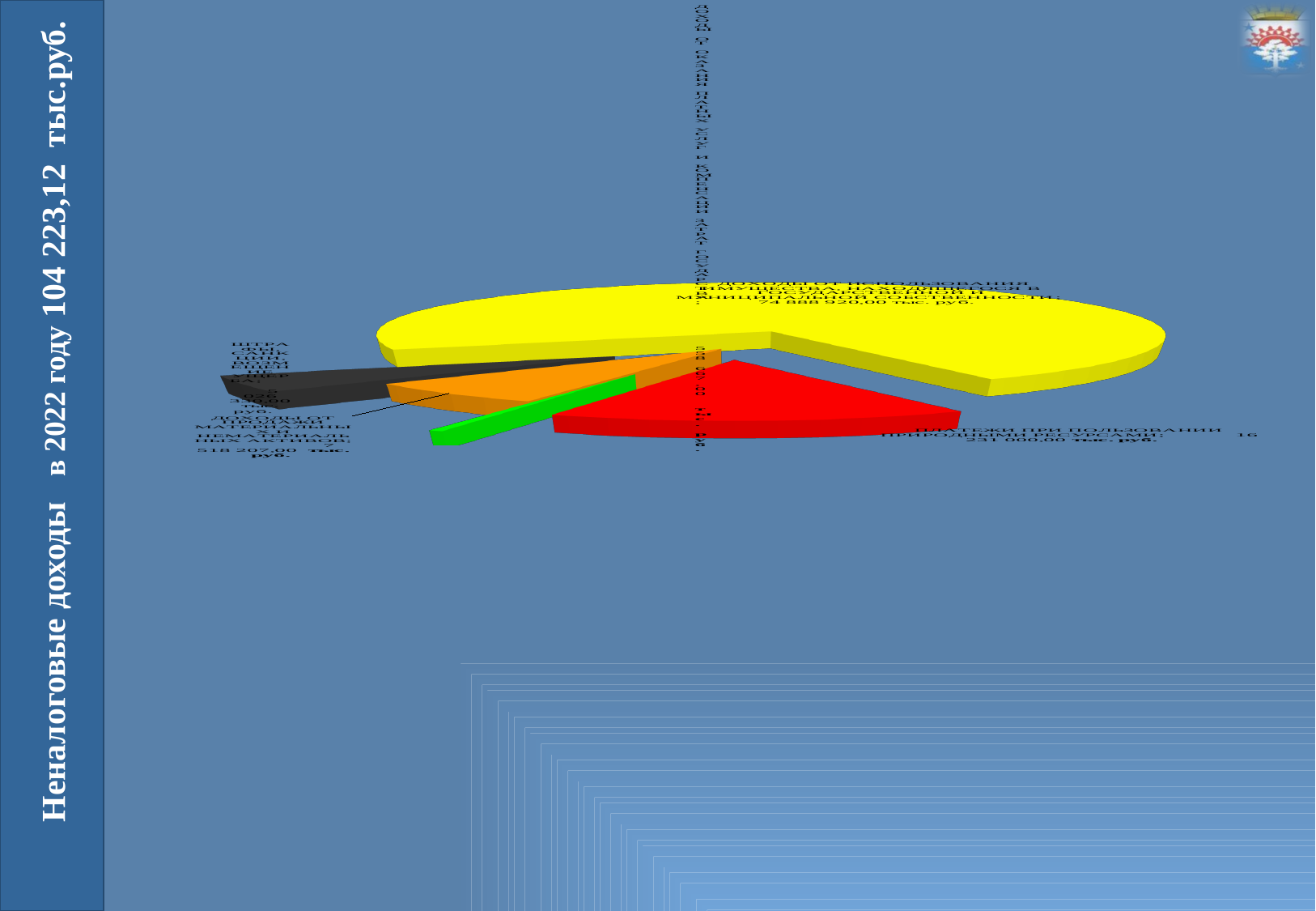
What value is labelled for the slice 'Доходы от продажи материальных и нематериальных активов'? 7 518 207,00 тыс. руб. What colour is the largest slice of the pie chart? yellow Which slice is larger: 'Платежи при пользовании природными ресурсами' or 'Доходы от использования имущества, находящегося в государственной и муниципальной собственности'? Доходы от использования имущества, находящегося в государственной и муниципальной собственности Which category has the largest slice of the pie chart? Доходы от использования имущества, находящегося в государственной и муниципальной собственности Which slice is larger: 'Платежи при пользовании природными ресурсами' or 'Доходы от продажи материальных и нематериальных активов'? Платежи при пользовании природными ресурсами How many slices does the pie chart have? 5 What colour is the slice for 'Платежи при пользовании природными ресурсами'? red What kind of chart is shown on the slide? pie chart What value is labelled for the slice 'Платежи при пользовании природными ресурсами'? 16 231 000,00 тыс. руб. What total amount of non-tax revenue for 2022 is stated in the slide title? 104 223,12 тыс.руб.